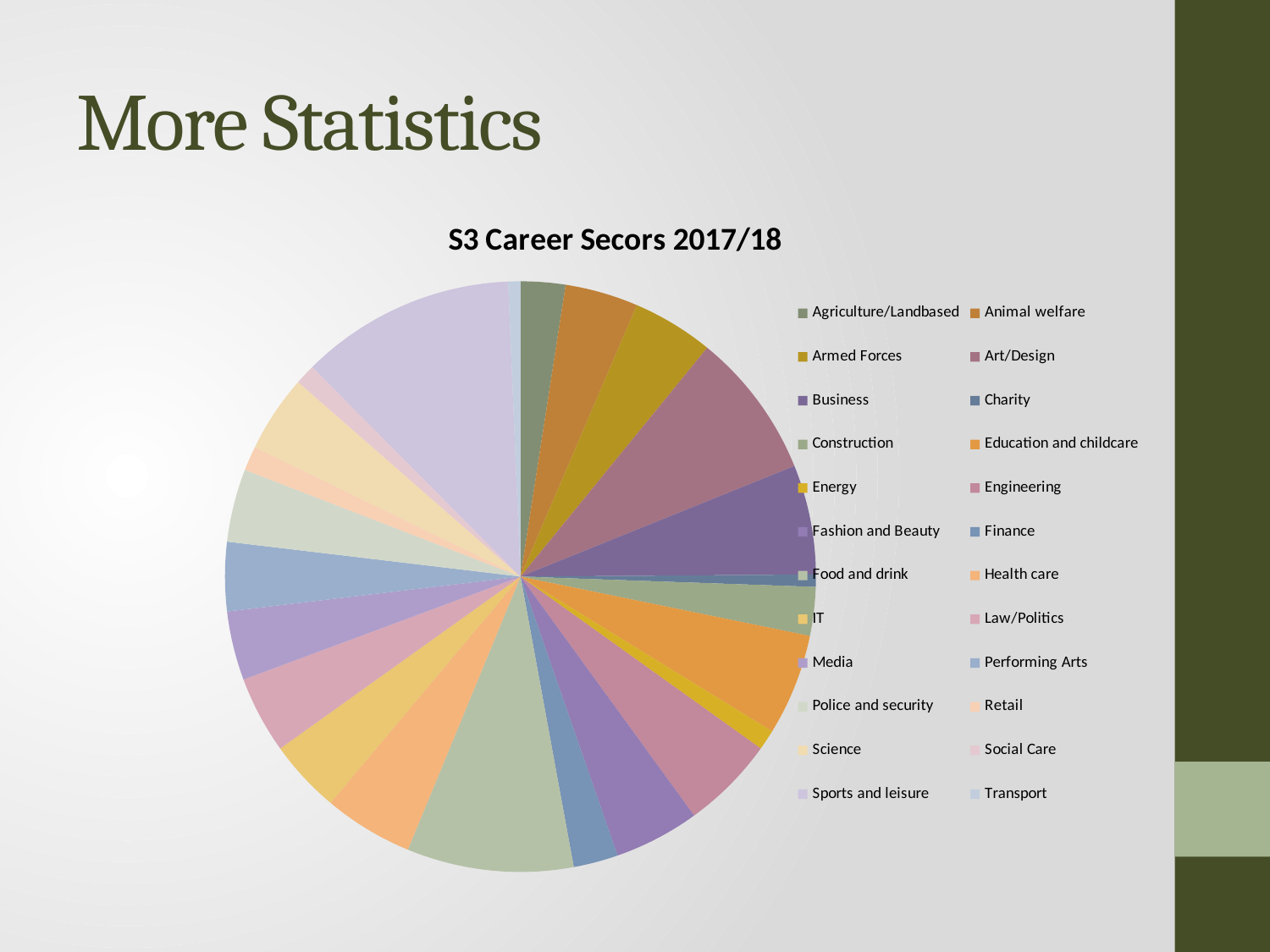
Which slice is larger, Art/Design or Charity? Art/Design Which career sector has the largest slice of the pie? Sports and leisure Which legend entry appears first in the chart's legend? Agriculture/Landbased How many career sectors are listed in the chart's legend? 24 What kind of chart is shown on the slide? pie chart Which slice is larger, Sports and leisure or Transport? Sports and leisure Which slice is larger, Sports and leisure or Business? Sports and leisure What is the title of the chart? S3 Career Secors 2017/18